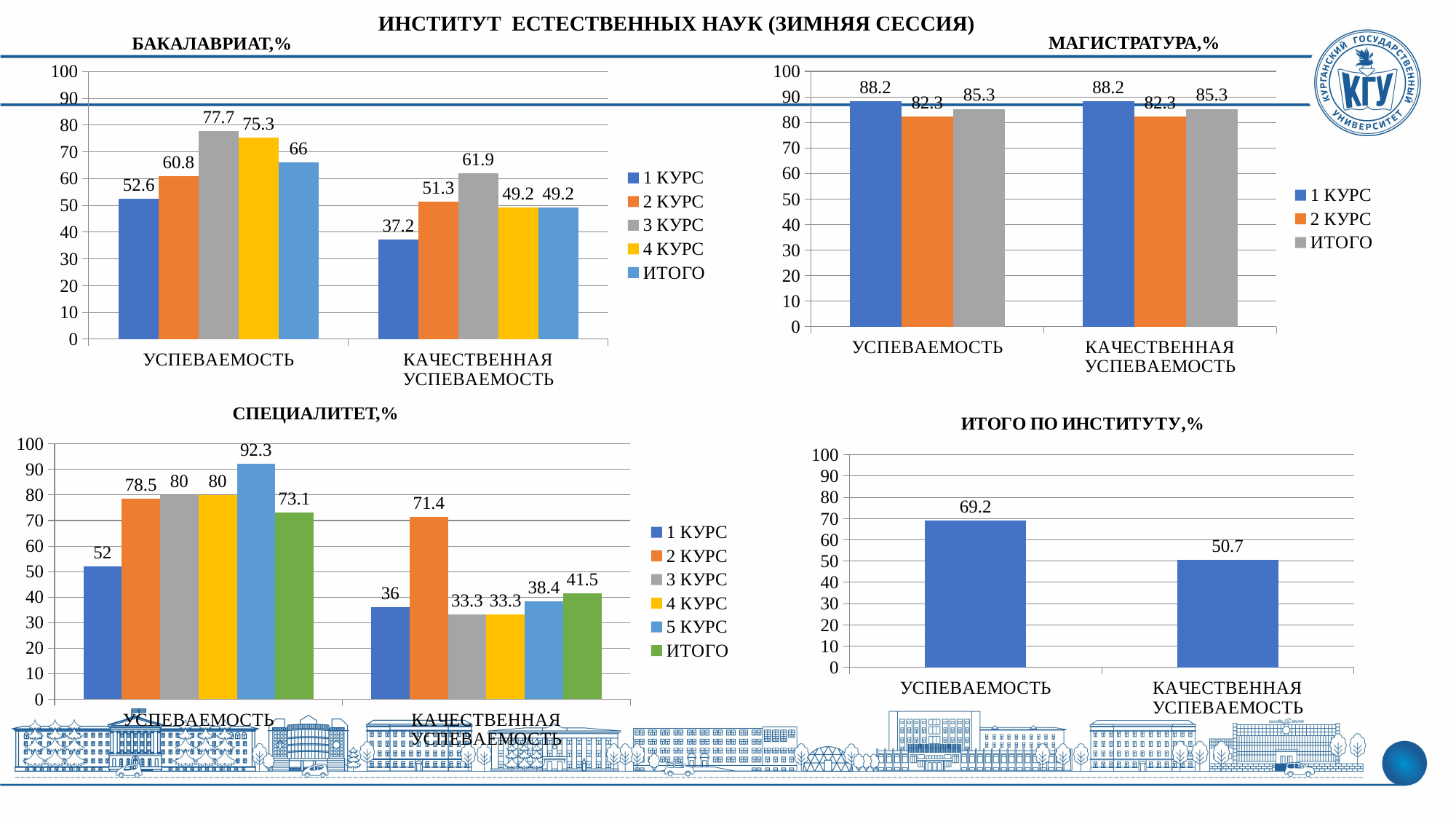
In the ИТОГО ПО ИНСТИТУТУ,% chart, what is the difference between УСПЕВАЕМОСТЬ and КАЧЕСТВЕННАЯ УСПЕВАЕМОСТЬ? 18.5 What kind of chart is the ИТОГО ПО ИНСТИТУТУ,% chart? Bar chart In the ИТОГО ПО ИНСТИТУТУ,% chart, what is the value for КАЧЕСТВЕННАЯ УСПЕВАЕМОСТЬ? 50.7 In the БАКАЛАВРИАТ,% chart, what is the value for 3 КУРС in the УСПЕВАЕМОСТЬ category? 77.7 How many series does the legend of the СПЕЦИАЛИТЕТ,% chart list? 6 In the МАГИСТРАТУРА,% chart, which series has the highest value in the КАЧЕСТВЕННАЯ УСПЕВАЕМОСТЬ category? 1 КУРС In the БАКАЛАВРИАТ,% chart, what is the difference between the ИТОГО values for УСПЕВАЕМОСТЬ and КАЧЕСТВЕННАЯ УСПЕВАЕМОСТЬ? 16.8 How many series does the legend of the БАКАЛАВРИАТ,% chart list? 5 In the МАГИСТРАТУРА,% chart, what is the value for 2 КУРС in the УСПЕВАЕМОСТЬ category? 82.3 In the БАКАЛАВРИАТ,% chart, which series has the lowest value in the КАЧЕСТВЕННАЯ УСПЕВАЕМОСТЬ category? 1 КУРС In the СПЕЦИАЛИТЕТ,% chart, what is the value for 5 КУРС in the УСПЕВАЕМОСТЬ category? 92.3 In the СПЕЦИАЛИТЕТ,% chart, which is larger in the КАЧЕСТВЕННАЯ УСПЕВАЕМОСТЬ category: 2 КУРС or 1 КУРС? 2 КУРС